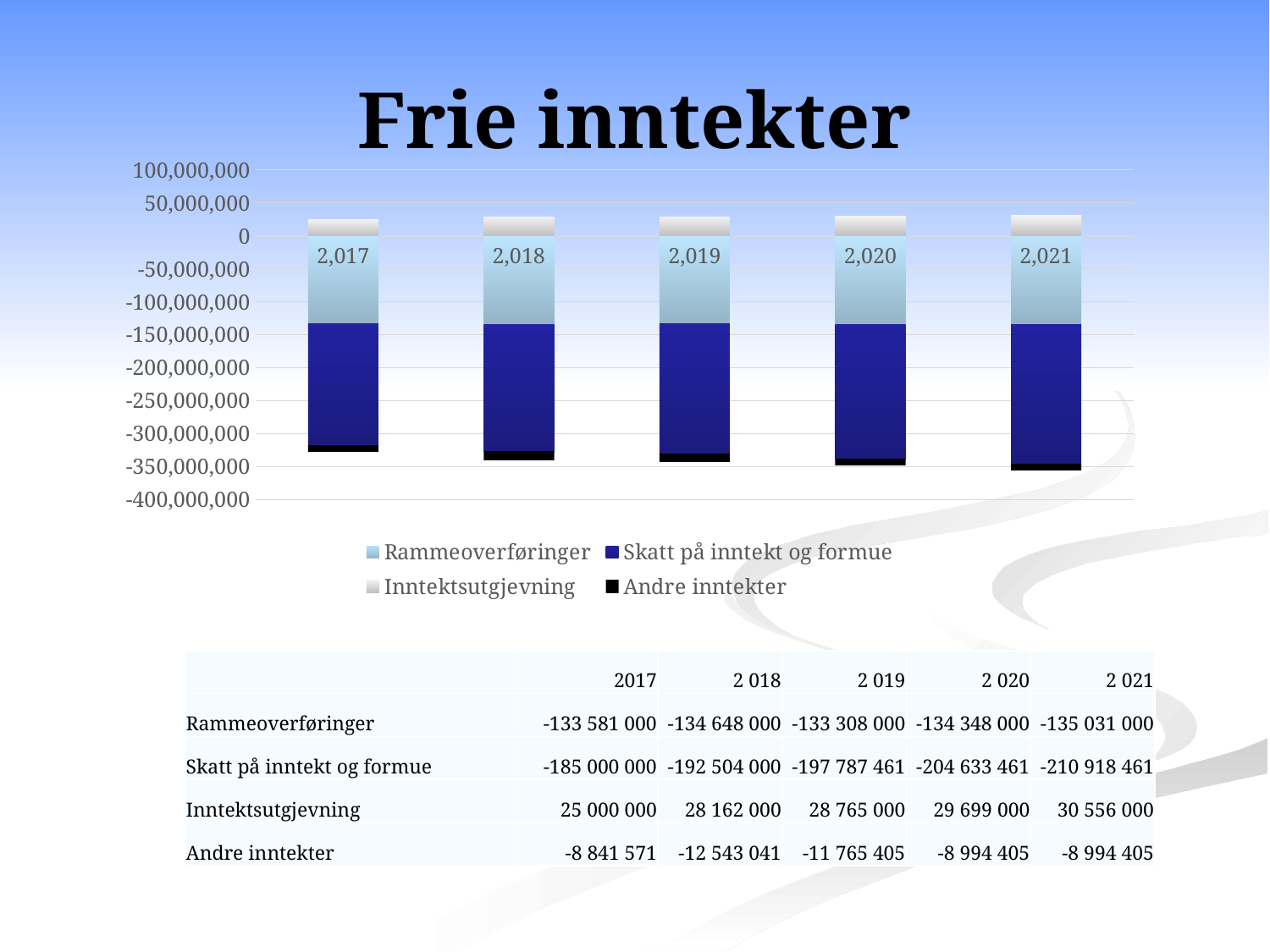
What is the value of Andre inntekter for 2018? -12 543 041 How many series does the legend list? 4 Does Inntektsutgjevning rise or fall from 2017 to 2021? Rise In which year is Inntektsutgjevning highest? 2021 How many years (categories) are plotted in the chart? 5 Which is larger in magnitude for 2020: Rammeoverføringer or Skatt på inntekt og formue? Skatt på inntekt og formue What is the value of Skatt på inntekt og formue for 2021? -210 918 461 What is the difference between Inntektsutgjevning in 2021 and in 2017? 5 556 000 What is the value of Inntektsutgjevning for 2019? 28 765 000 What type of chart is shown on the slide? Stacked bar chart What is the value of Rammeoverføringer for 2017? -133 581 000 In which year is Andre inntekter lowest (most negative)? 2018